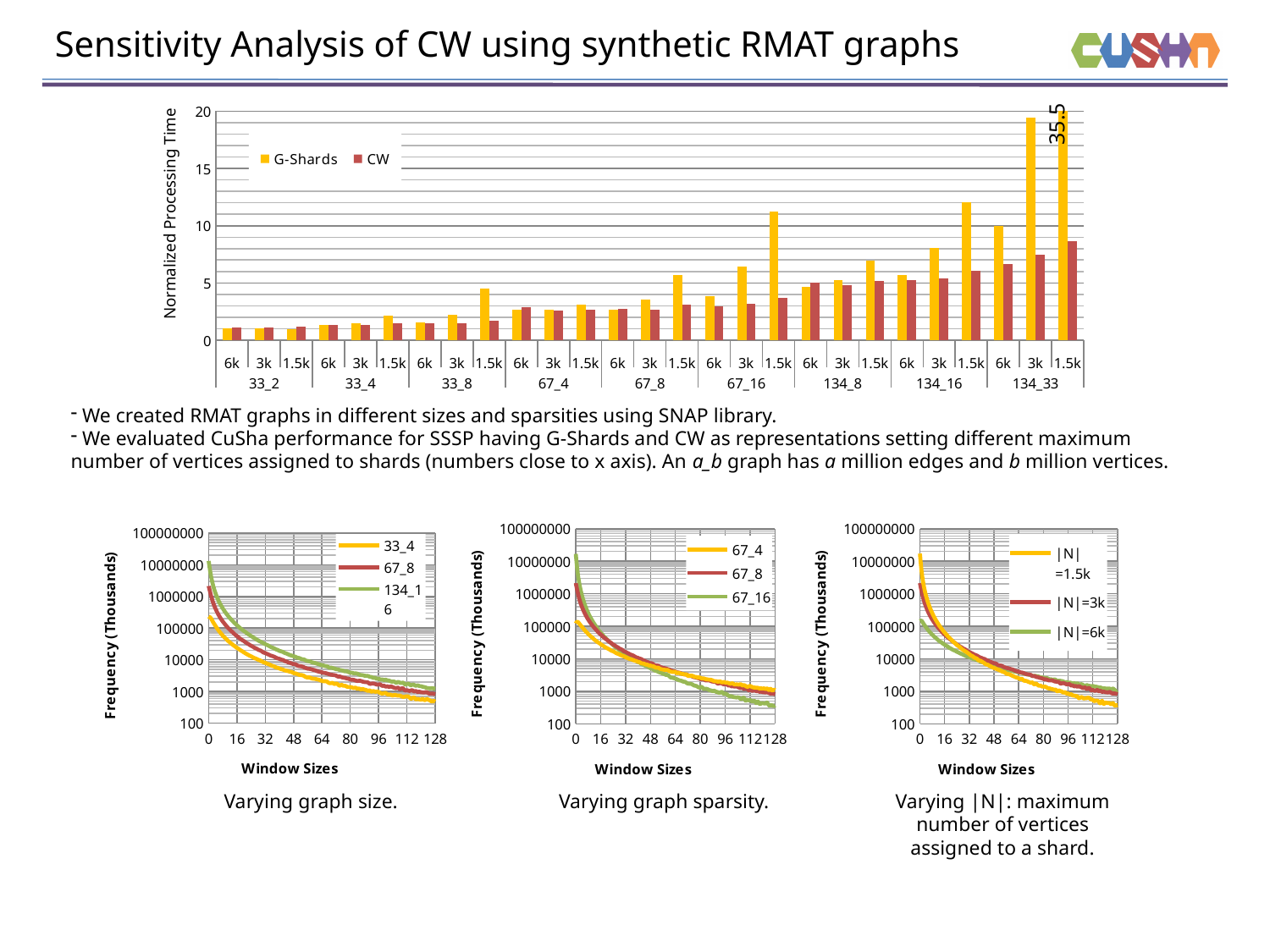
In the bottom-right chart (Varying |N|), do the frequency values rise or fall as window size increases? fall In the top chart (Normalized Processing Time), is the CW value for 134_33 at 1.5k greater or less than 10? less In the bottom-left chart (Varying graph size), how many series does the legend list? 3 In the top chart (Normalized Processing Time), is the G-Shards value for 67_16 at 1.5k greater or less than 10? greater In the bottom-middle chart (Varying graph sparsity), what kind of chart is it? line chart In the top chart (Normalized Processing Time), for the 134_16 graph at 1.5k, which series has the larger value, G-Shards or CW? G-Shards In the top chart (Normalized Processing Time), which series has the highest bar overall? G-Shards In the top chart (Normalized Processing Time), how many series does the legend list? 2 In the bottom-right chart (Varying |N|), what are the three legend entries? |N|=1.5k, |N|=3k, |N|=6k In the top chart (Normalized Processing Time), what kind of chart is it? bar chart In the top chart (Normalized Processing Time), what is the G-Shards value for the 134_33 graph with 1.5k vertices per shard? 35.5 In the top chart (Normalized Processing Time), how many graph groups (such as 33_2, 33_4) are shown on the x axis? 9